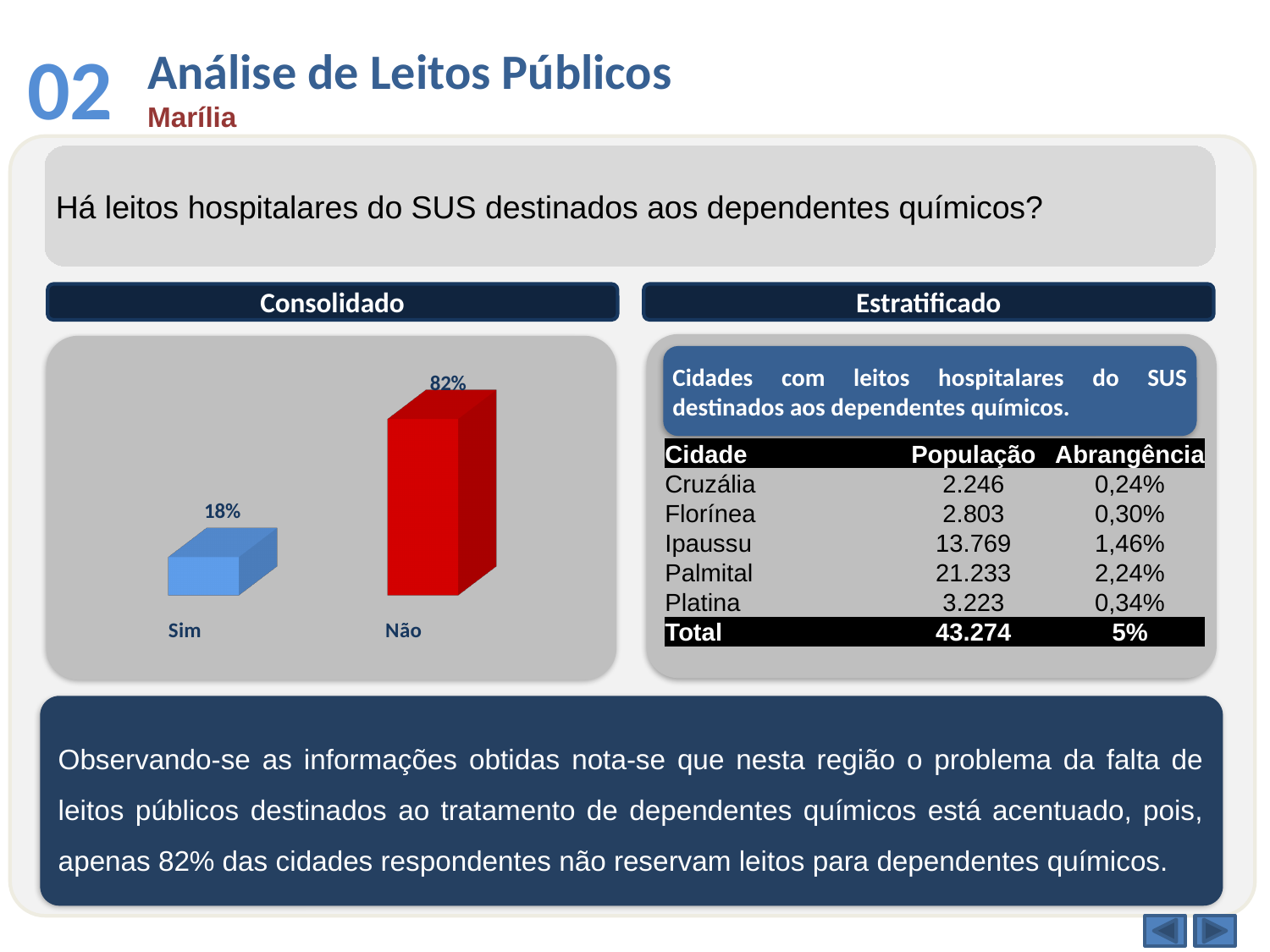
What is the value for "Não" in the Consolidado bar chart? 82% What colour is the "Não" bar in the Consolidado bar chart? Red How many categories are shown in the Consolidado bar chart? 2 In the Consolidado bar chart, which is larger: the value for "Sim" or the value for "Não"? Não What is the value for "Sim" in the Consolidado bar chart? 18% What colour is the "Sim" bar in the Consolidado bar chart? Blue Which category has the lowest value in the Consolidado bar chart? Sim Which category has the highest value in the Consolidado bar chart? Não What is the total of the two values shown in the Consolidado bar chart? 100% What is the difference between the "Não" and "Sim" values in the Consolidado bar chart? 64% What kind of chart is shown under the Consolidado heading? Bar chart